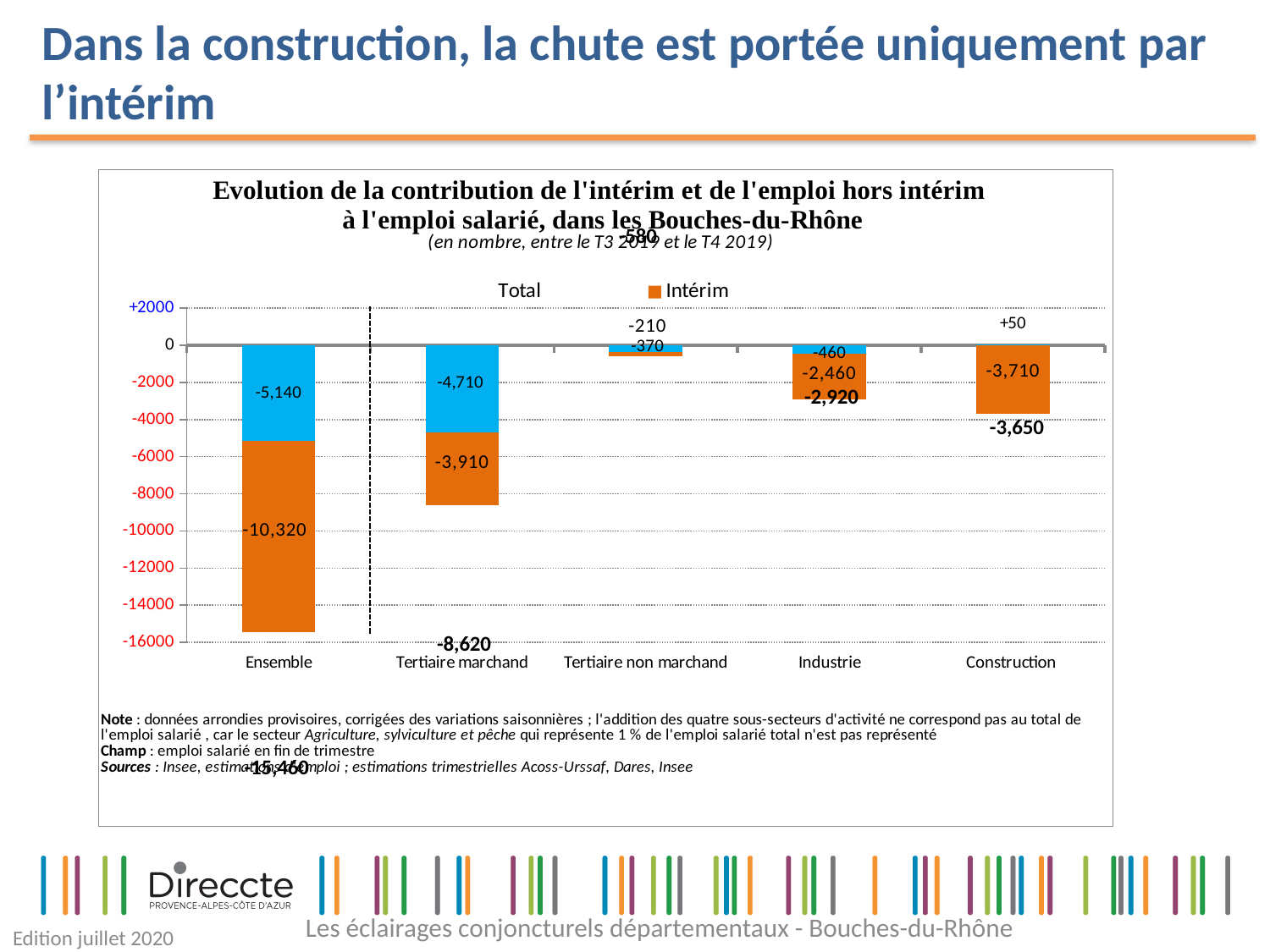
What is the Intérim value for Industrie? -2,460 What is the Intérim value for Ensemble? -10,320 How many categories are shown on the x axis? 5 What is the value of the blue (non-Intérim) segment for Tertiaire marchand? -4,710 What is the total shown for Industrie? -2,920 What is the total shown for Tertiaire marchand? -8,620 What is the difference between the Intérim values for Construction and Industrie? 1,250 Which category has the most negative Intérim value? Ensemble What is the Intérim value for Construction? -3,710 What kind of chart is this? Stacked bar chart Which has the more negative Intérim value, Tertiaire marchand or Construction? Tertiaire marchand Is the total for Ensemble greater or less than -14000? less